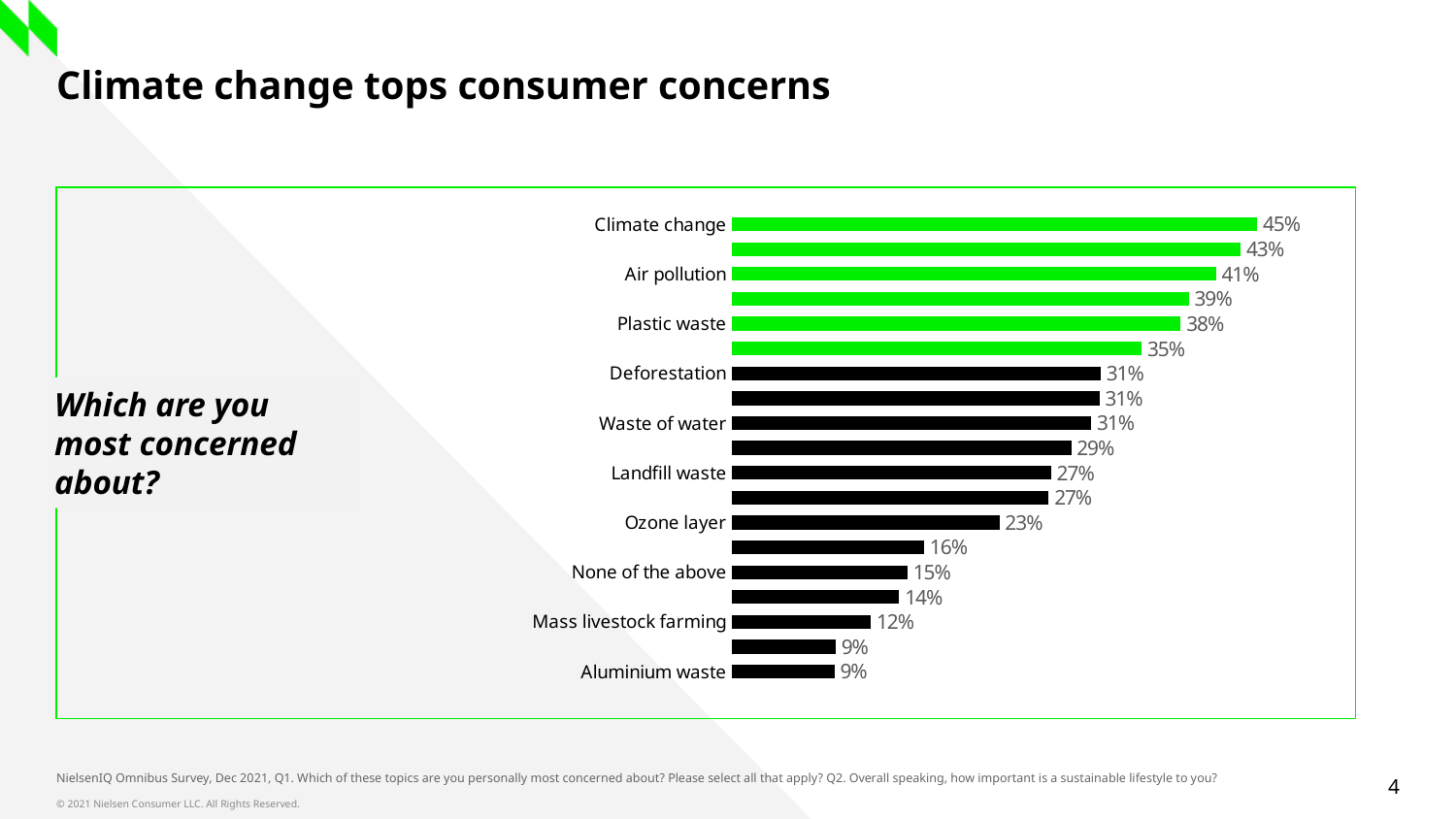
What is the lowest value shown on the chart? 9% What is the value for Ozone layer? 23% Which is larger, the value for Landfill waste or the value for Ozone layer? Landfill waste What is the difference between the values for Climate change and Air pollution? 4 percentage points Which labelled category has the highest value? Climate change What kind of chart is shown on the slide? Bar chart What is the difference between the values for Plastic waste and Deforestation? 7 percentage points What is the title of the slide? Climate change tops consumer concerns What is the value for Air pollution? 41% What is the value for Climate change? 45% What is the value for Plastic waste? 38% What is the value for Mass livestock farming? 12%